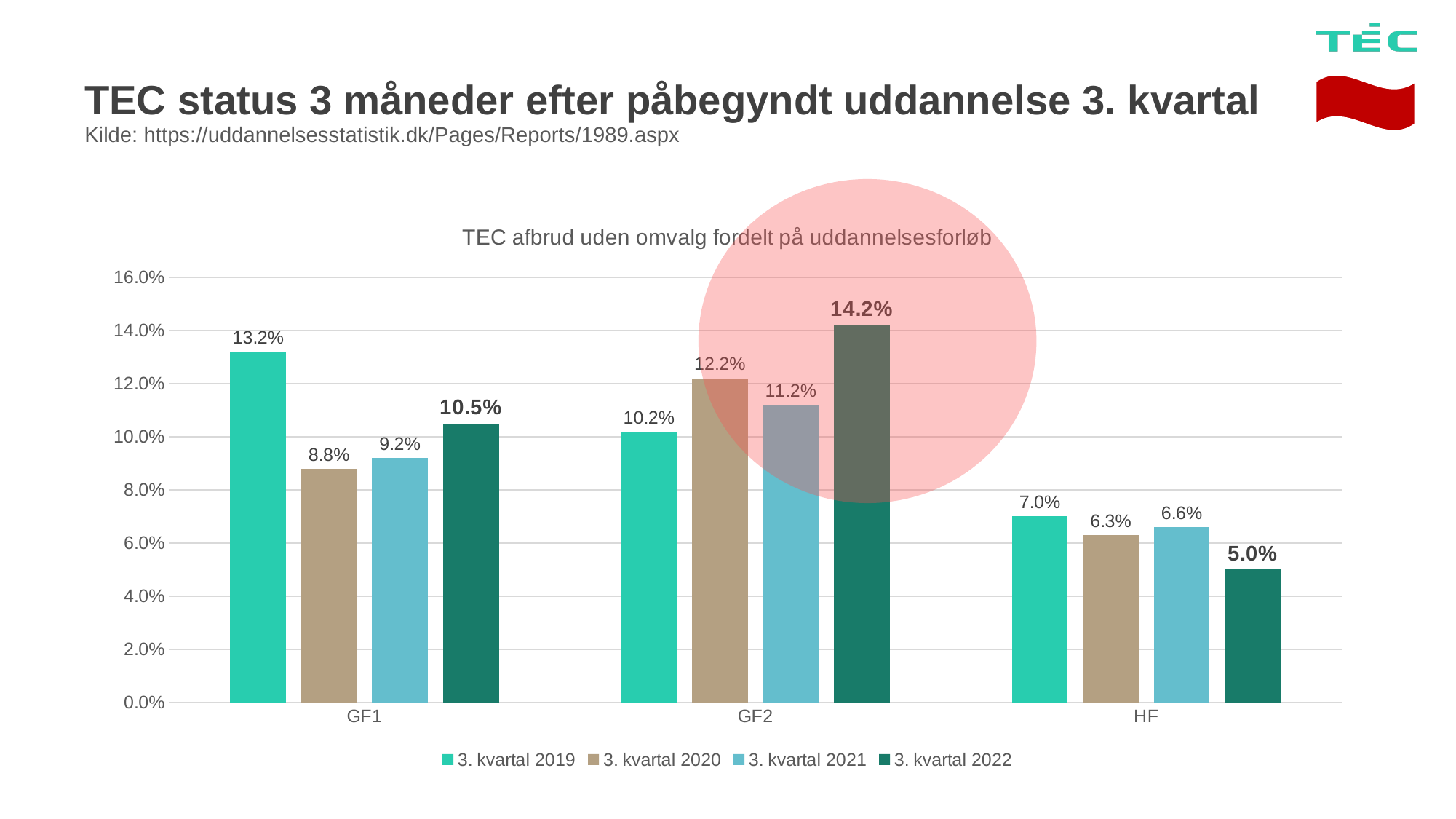
What kind of chart is shown on the slide? bar chart Which category has the highest value in the 3. kvartal 2021 series? GF2 Which is larger for GF1: the 3. kvartal 2020 value or the 3. kvartal 2021 value? 3. kvartal 2021 What is the value for HF in the 3. kvartal 2020 series? 6.3% Is the value for HF in the 3. kvartal 2019 series greater or less than 8.0%? less What is the value for GF2 in the 3. kvartal 2022 series? 14.2% What is the value for GF1 in the 3. kvartal 2019 series? 13.2% What is the title of the chart? TEC afbrud uden omvalg fordelt på uddannelsesforløb How many series does the legend list? 4 What is the difference between the 3. kvartal 2022 and 3. kvartal 2019 values for GF2? 4.0% How many categories are shown on the x axis? 3 Which category has the lowest value in the 3. kvartal 2022 series? HF